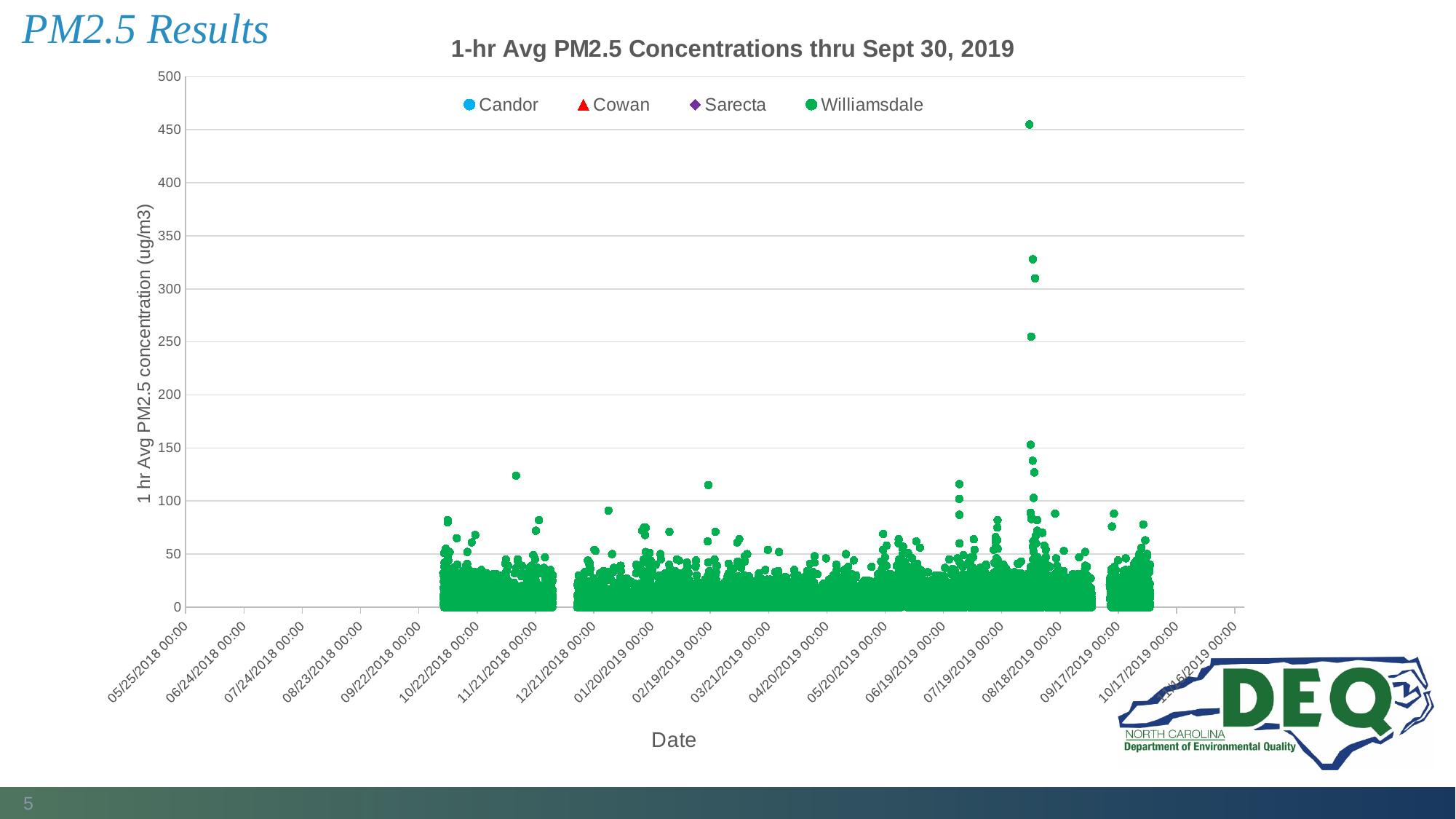
Is the highest plotted value near 11/21/2018 greater or less than 100? greater How many series does the chart legend list? 4 Which series in the legend is plotted with green circle markers? Williamsdale Is the highest plotted PM2.5 value on the chart greater or less than 400? greater Is the highest plotted PM2.5 value on the chart greater or less than 350? greater What kind of chart is shown on the slide? scatter chart Around which x-axis date does the highest plotted point occur? 08/18/2019 00:00 What is the label of the y axis? 1 hr Avg PM2.5 concentration (ug/m3) What is the maximum value shown on the y axis? 500